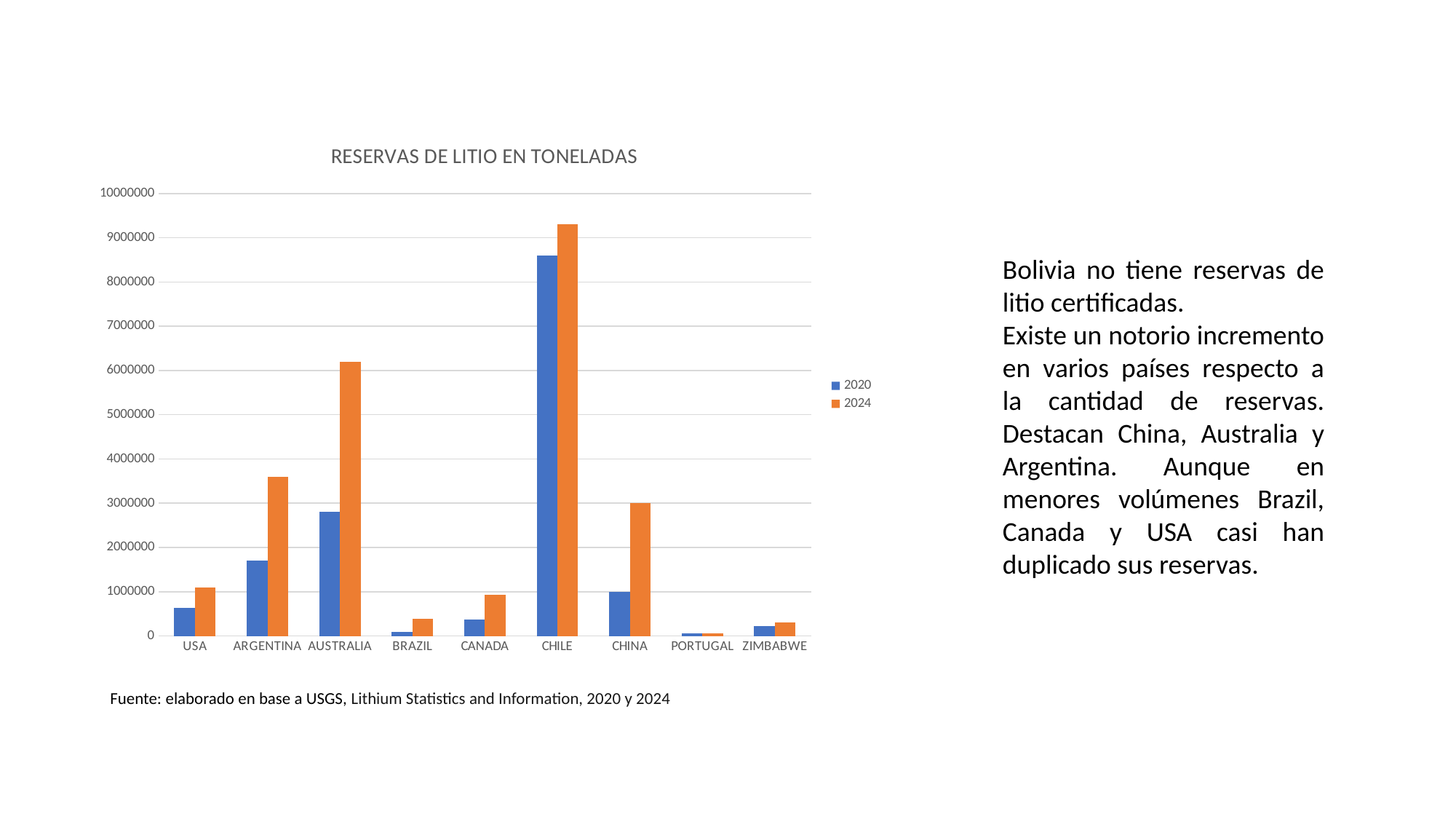
Which is larger, the 2020 value for CHINA or the 2020 value for ARGENTINA? ARGENTINA How many series does the legend list? 2 Which is larger, the 2024 value for AUSTRALIA or the 2024 value for ARGENTINA? AUSTRALIA What is the title of the chart? RESERVAS DE LITIO EN TONELADAS Which country has the highest 2024 lithium reserves? CHILE Which country has the highest 2020 lithium reserves? CHILE Is the 2020 value for USA greater or less than 1000000? less What kind of chart is shown on the slide? bar chart Which country has the lowest 2024 lithium reserves? PORTUGAL Is the 2024 value for AUSTRALIA greater or less than 6000000? greater Is the 2024 value for CHILE greater or less than 9000000? greater How many countries are shown on the x axis? 9